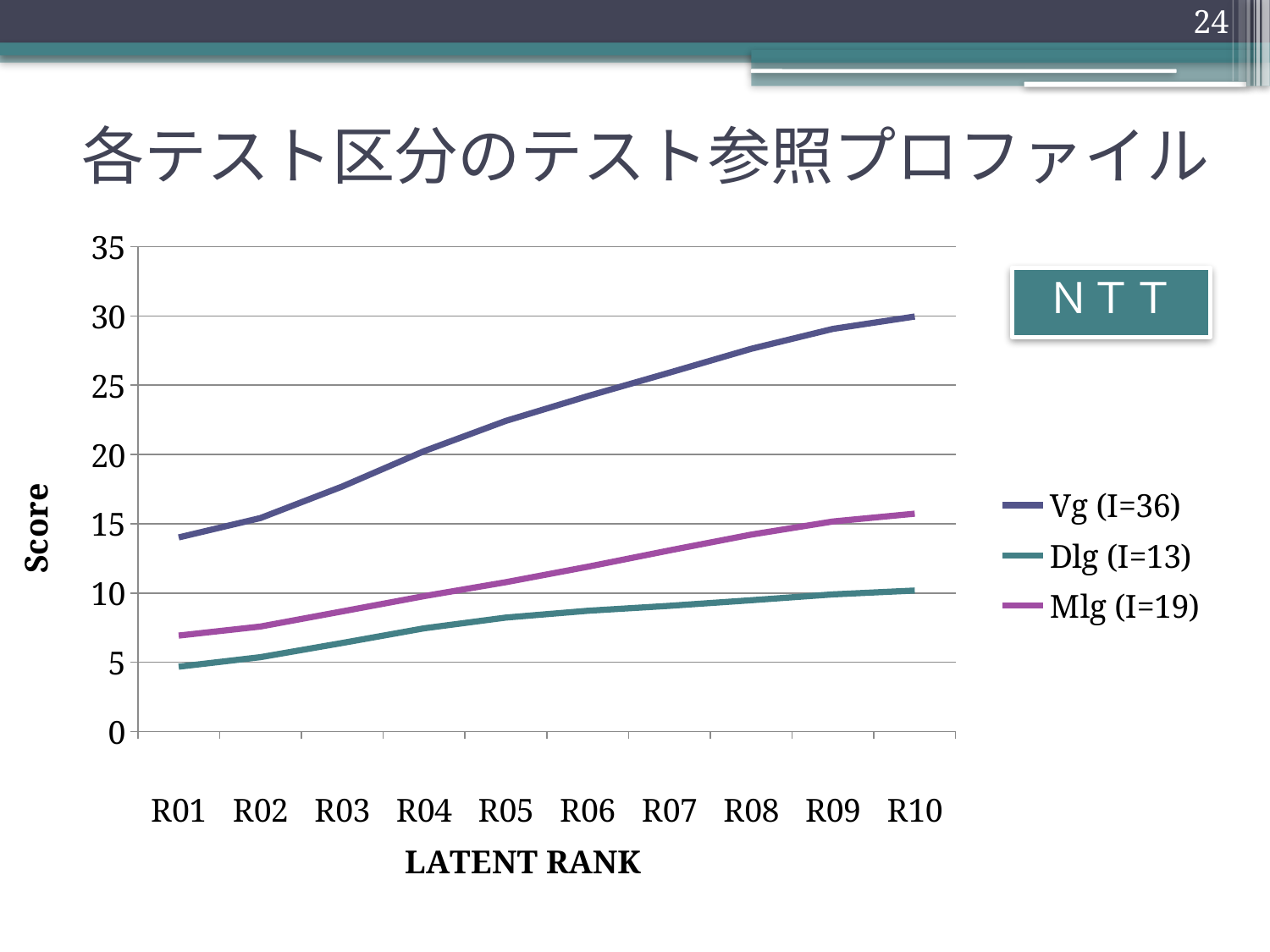
What is the title of the x axis? LATENT RANK Is the score for Mlg (I=19) at R10 greater or less than 10? greater How many series does the legend list? 3 What kind of chart is shown on the slide? line chart How many latent rank categories are shown on the x axis? 10 Is the score for Vg (I=36) at R10 greater or less than 25? greater Is the score for Vg (I=36) at R01 greater or less than 20? less Which series has the highest score at R10? Vg (I=36) Which series has the lowest score at R01? Dlg (I=13) At R10, which series has the larger score, Mlg (I=19) or Dlg (I=13)? Mlg (I=19) Do the scores for Vg (I=36) rise or fall from R01 to R10? rise